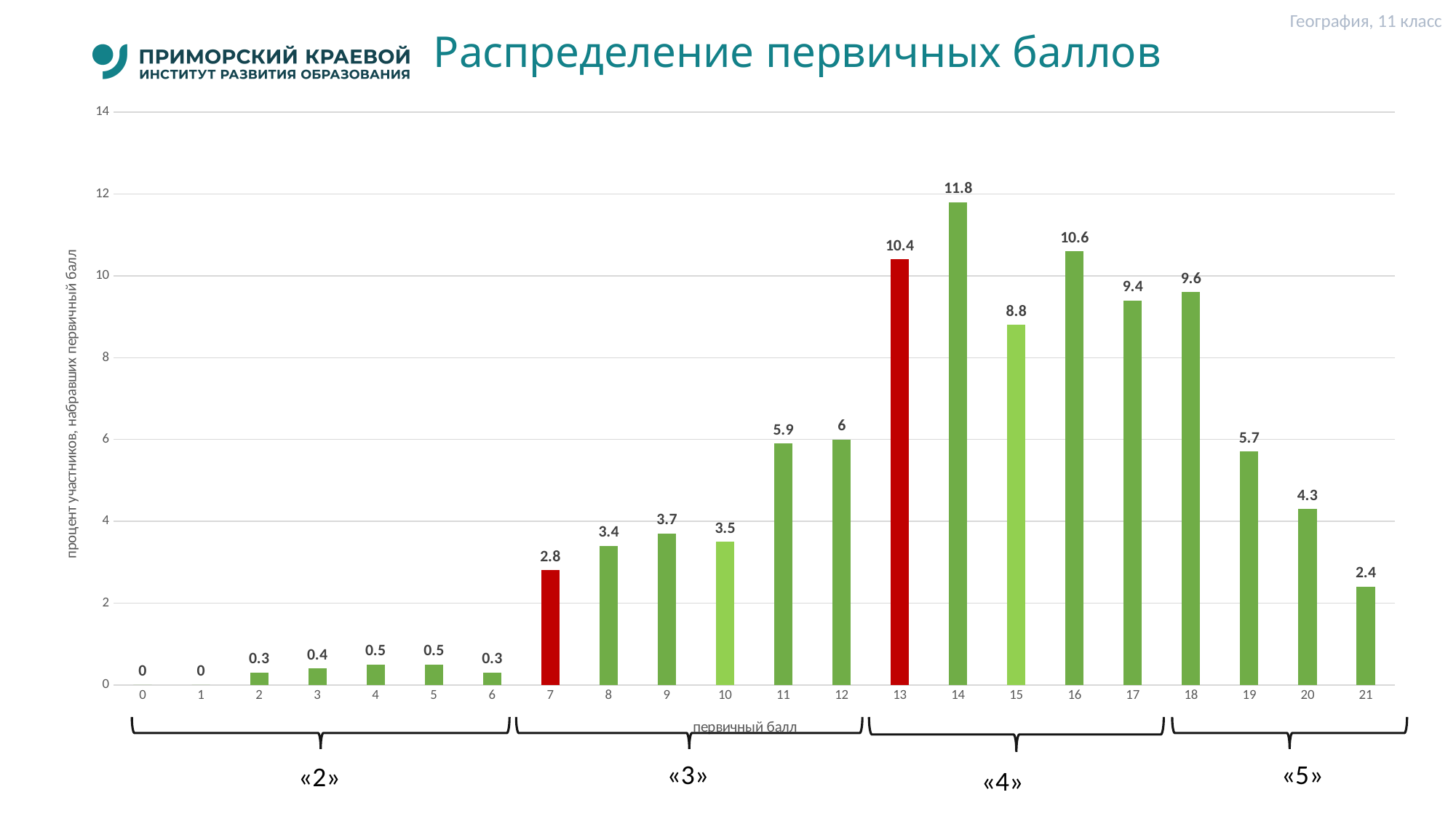
What is the value for primary score 14? 11.8 Which primary scores are shown with red bars? 7 and 13 Which is larger, the value for primary score 16 or for primary score 18? 16 What is the difference between the values for primary scores 16 and 15? 1.8 What is the title of the chart? Распределение первичных баллов What is the difference between the values for primary scores 14 and 13? 1.4 Which primary score has the highest percentage of participants? 14 How many primary score categories are shown on the x axis? 22 Is the value for primary score 13 greater or less than 10? greater What is the value for primary score 7? 2.8 What kind of chart is shown on the slide? bar chart What is the value for primary score 21? 2.4